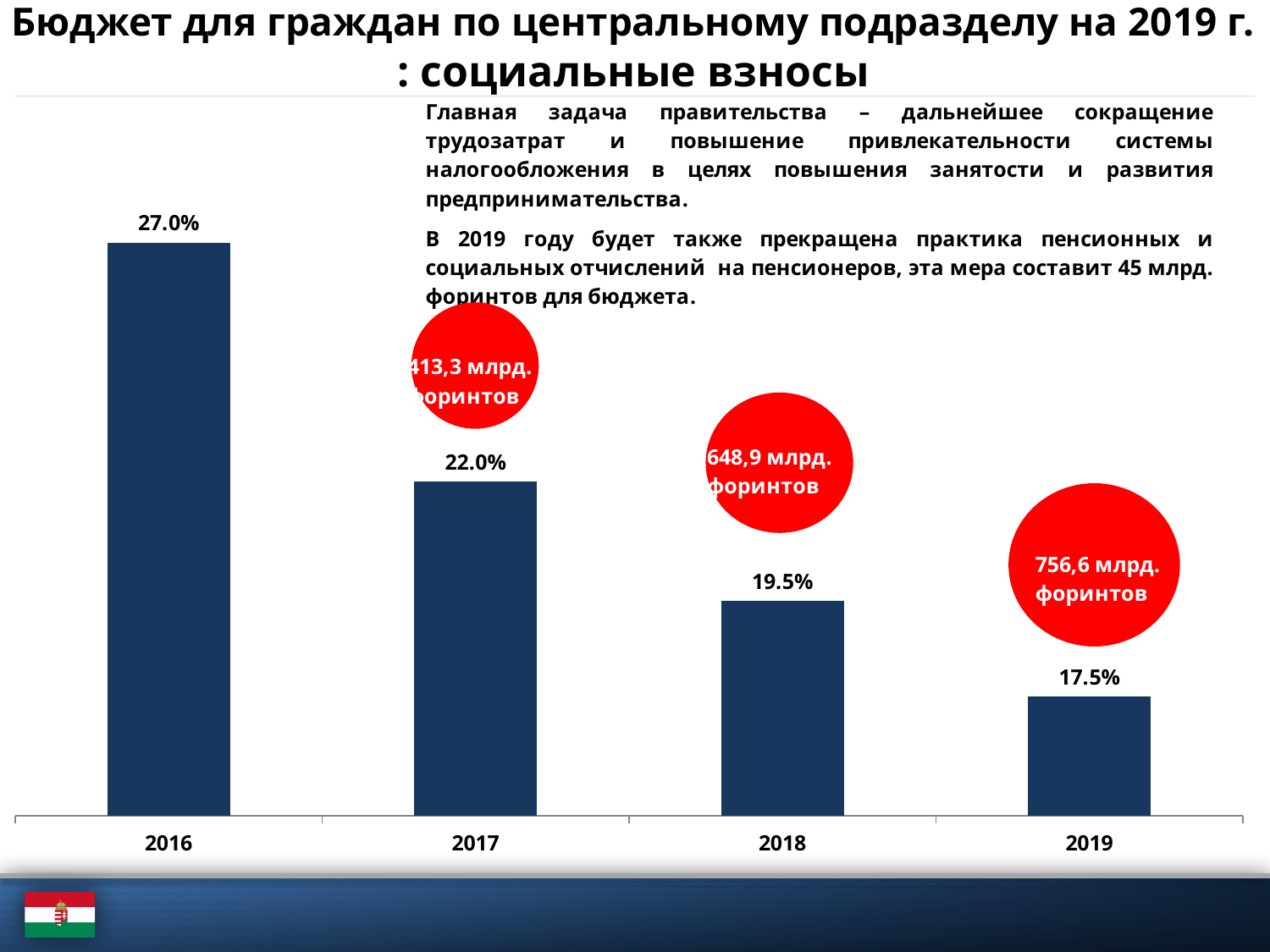
What is the value for 2016? 27.0% Which year has the lowest value? 2019 Which is larger, the value for 2017 or the value for 2018? 2017 What is the value for 2017? 22.0% What is the value for 2019? 17.5% What kind of chart is shown on the slide? Bar chart What is the difference between the values for 2016 and 2019? 9.5% What is the difference between the values for 2017 and 2018? 2.5% What is the value for 2018? 19.5% Do the values rise or fall from 2016 to 2019? Fall How many years are shown on the x axis? 4 Which year has the highest value? 2016